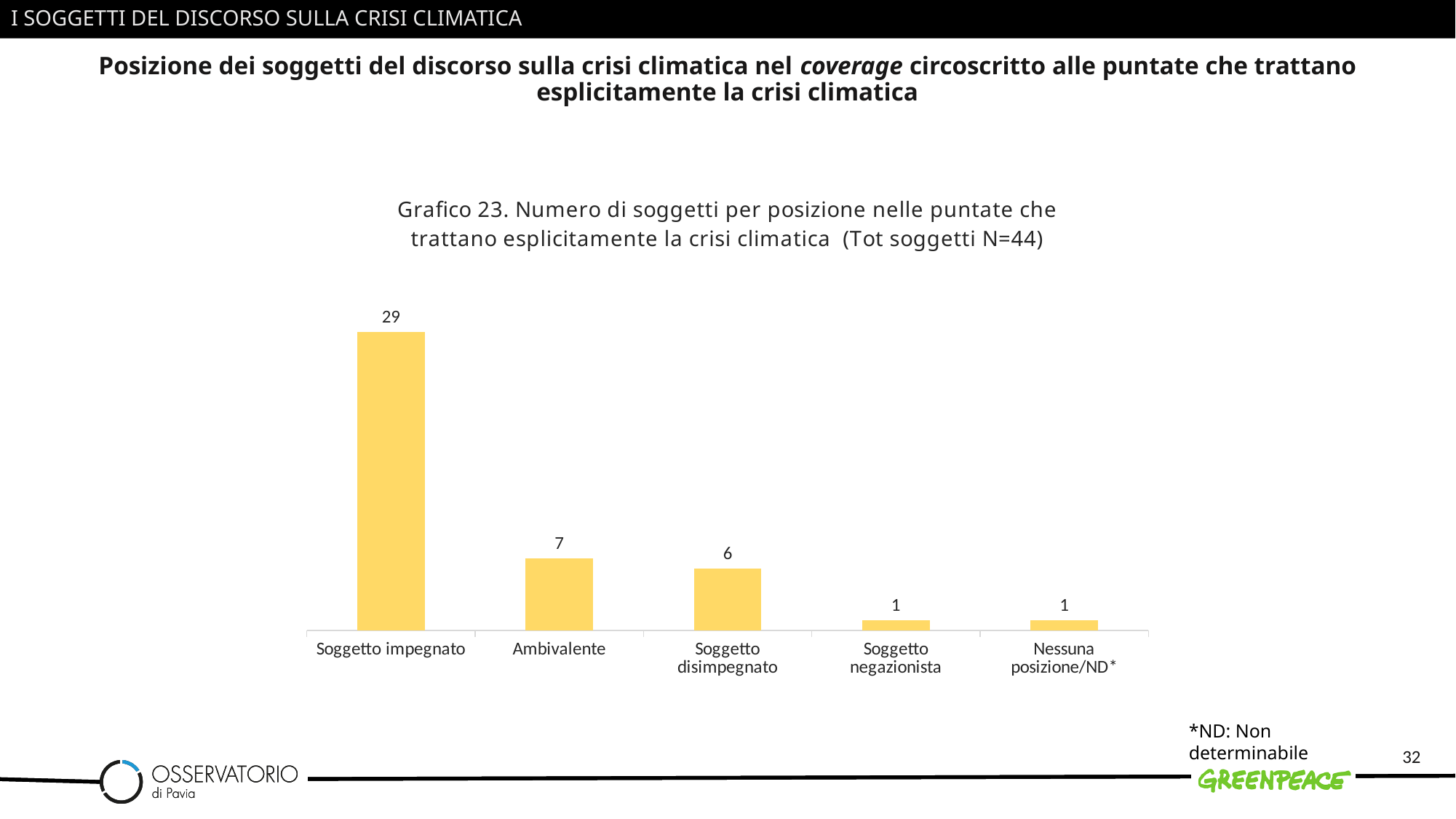
What is the value for Soggetto negazionista? 1 What is the value for Soggetto impegnato? 29 What kind of chart is shown on the slide? Bar chart How many categories are shown on the x axis? 5 Which is larger, the value for Ambivalente or the value for Soggetto disimpegnato? Ambivalente What is the total number of subjects (N) stated in the chart title? 44 What is the value for Ambivalente? 7 What is the difference between the values for Soggetto impegnato and Ambivalente? 22 What is the value for Soggetto disimpegnato? 6 What does the asterisk note say ND stands for? Non determinabile What is the difference between the values for Ambivalente and Soggetto disimpegnato? 1 Which category has the highest value? Soggetto impegnato